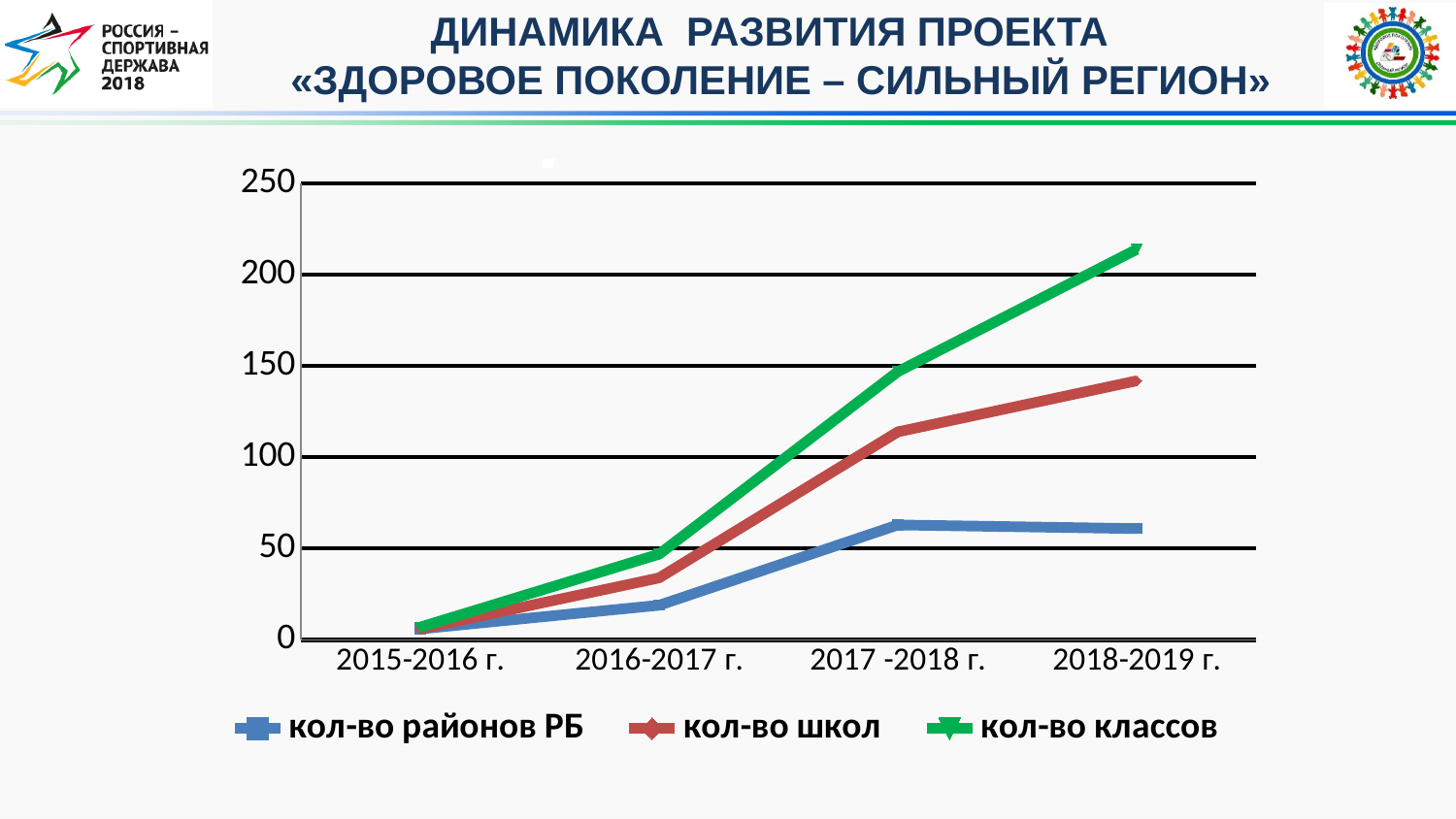
How many periods are shown on the x axis? 4 In 2017 -2018 г., which is larger: кол-во школ or кол-во районов РБ? кол-во школ Does the кол-во классов series rise or fall from 2015-2016 г. to 2018-2019 г.? rise Which series has the highest value in 2018-2019 г.? кол-во классов What colour is the line for кол-во школ? red Is the value for кол-во школ in 2017 -2018 г. greater or less than 100? greater Is the value for кол-во школ in 2018-2019 г. greater or less than 150? less Is the value for кол-во районов РБ in 2017 -2018 г. greater or less than 50? greater Which series has the lowest value in 2018-2019 г.? кол-во районов РБ How many series does the legend list? 3 What kind of chart is shown on the slide? line chart